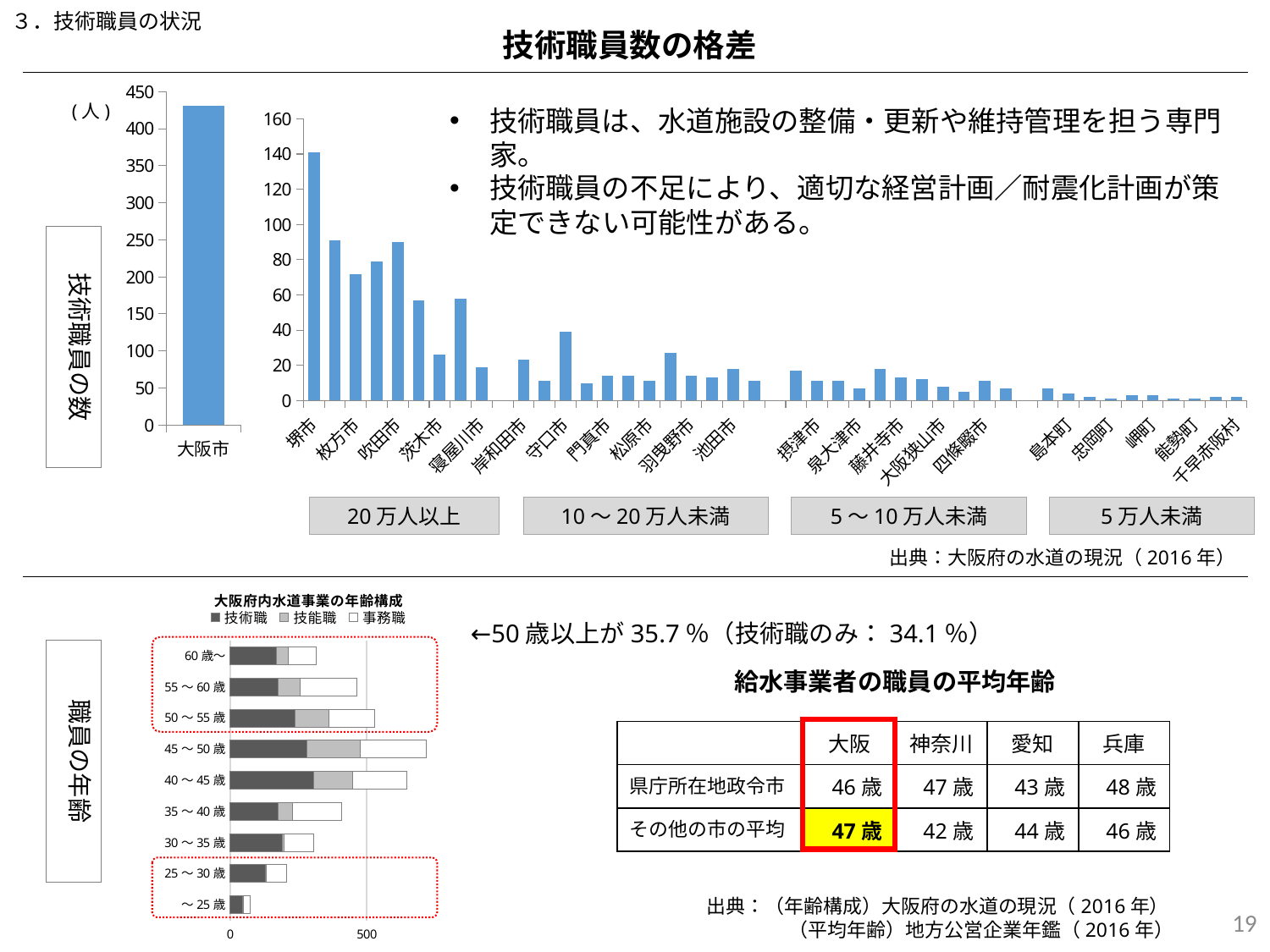
In the wide bar chart of technical staff by municipality at the top, is the value for 門真市 greater or less than 20? less In the wide bar chart of technical staff by municipality at the top, is the value for 堺市 greater or less than 120? greater In the stacked bar chart 大阪府内水道事業の年齢構成 at the bottom left, how many series does the legend list? 3 What kind of chart is the top-left chart showing 大阪市? bar chart In the stacked bar chart 大阪府内水道事業の年齢構成 at the bottom left, which age group has the longest total bar? 45～50歳 In the wide bar chart of technical staff by municipality at the top, what are the four population-size group labels shown below the chart? 20万人以上, 10～20万人未満, 5～10万人未満, 5万人未満 In the stacked bar chart 大阪府内水道事業の年齢構成 at the bottom left, how many age groups are shown? 9 In the wide bar chart of technical staff by municipality at the top, which municipality has the highest value? 堺市 In the wide bar chart of technical staff by municipality at the top, which is larger, the value for 茨木市 or the value for 岸和田市? 茨木市 In the bar chart at the top left showing 大阪市, is the value for 大阪市 greater or less than 400? greater